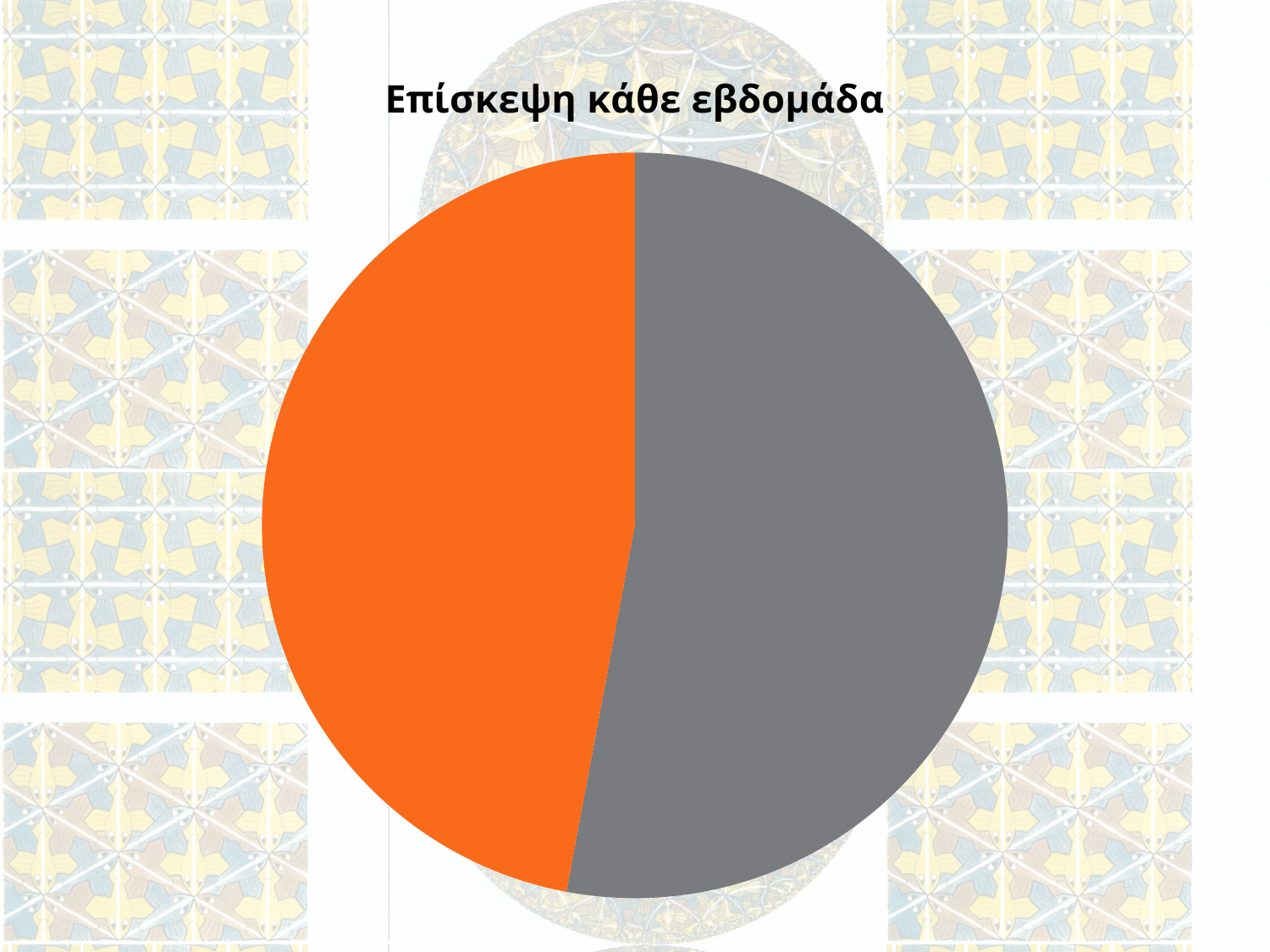
Which slice of the pie chart is larger, the gray one or the orange one? the gray one How many slices does the pie chart have? 2 Which slice takes up the largest share of the pie chart? the gray slice What kind of chart is shown on the slide? pie chart What two colours are used for the slices of the pie chart? orange and gray What is the title of the pie chart? Επίσκεψη κάθε εβδομάδα